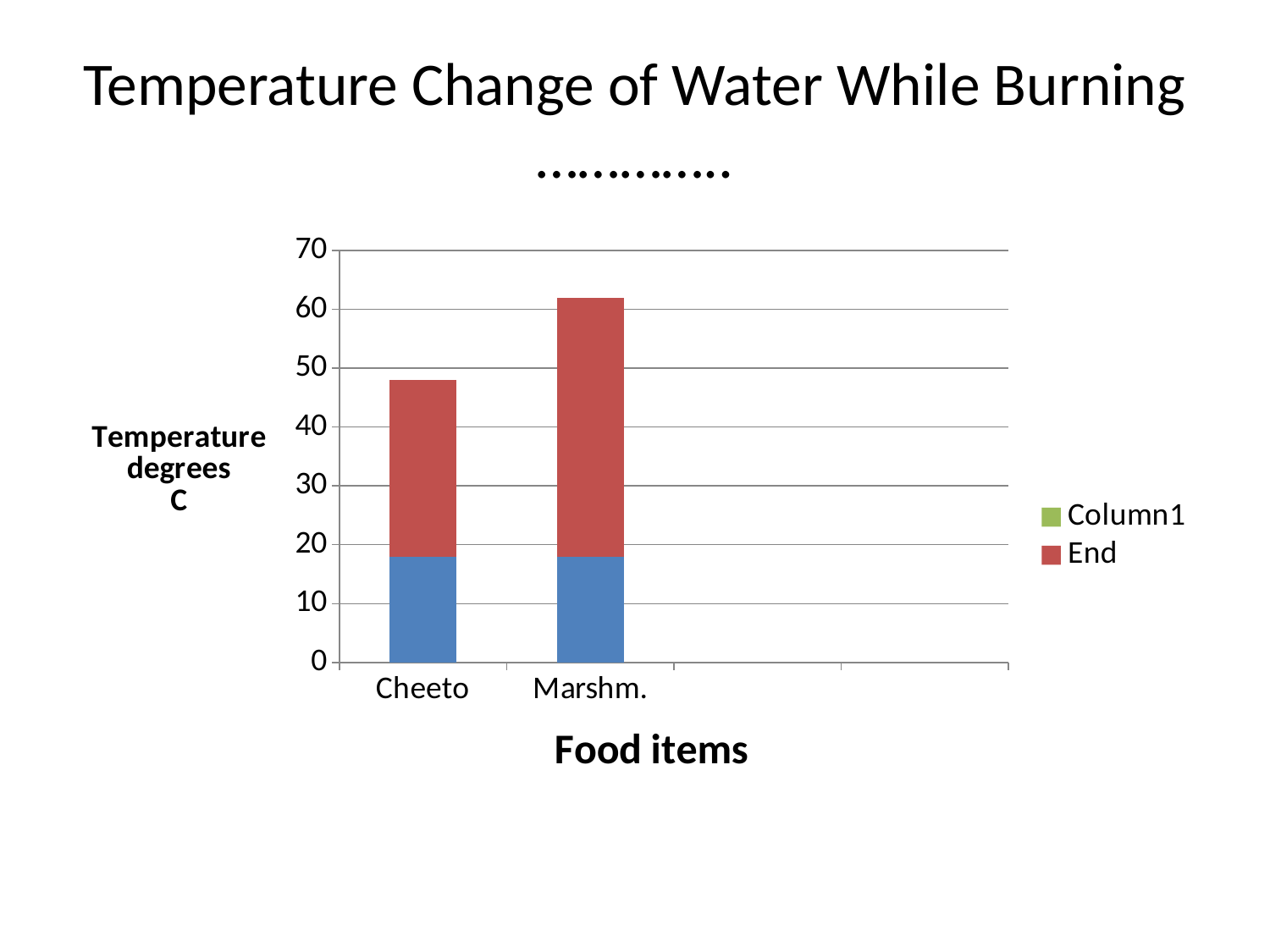
Which food item has the shortest bar in the chart? Cheeto Which bar is taller overall, Cheeto or Marshm.? Marshm. What kind of chart is shown on the slide? bar chart How many food items are shown on the x axis of the chart? 2 What is the title of the chart's x axis? Food items Is the total height of the Cheeto bar greater or less than 40? greater Is the total height of the Cheeto bar greater or less than 50? less Which food item has the tallest bar in the chart? Marshm. Do the bar heights rise or fall from Cheeto to Marshm. along the x axis? rise What are the two entries listed in the chart's legend? Column1 and End How many series does the chart's legend list? 2 Is the total height of the Marshm. bar greater or less than 60? greater